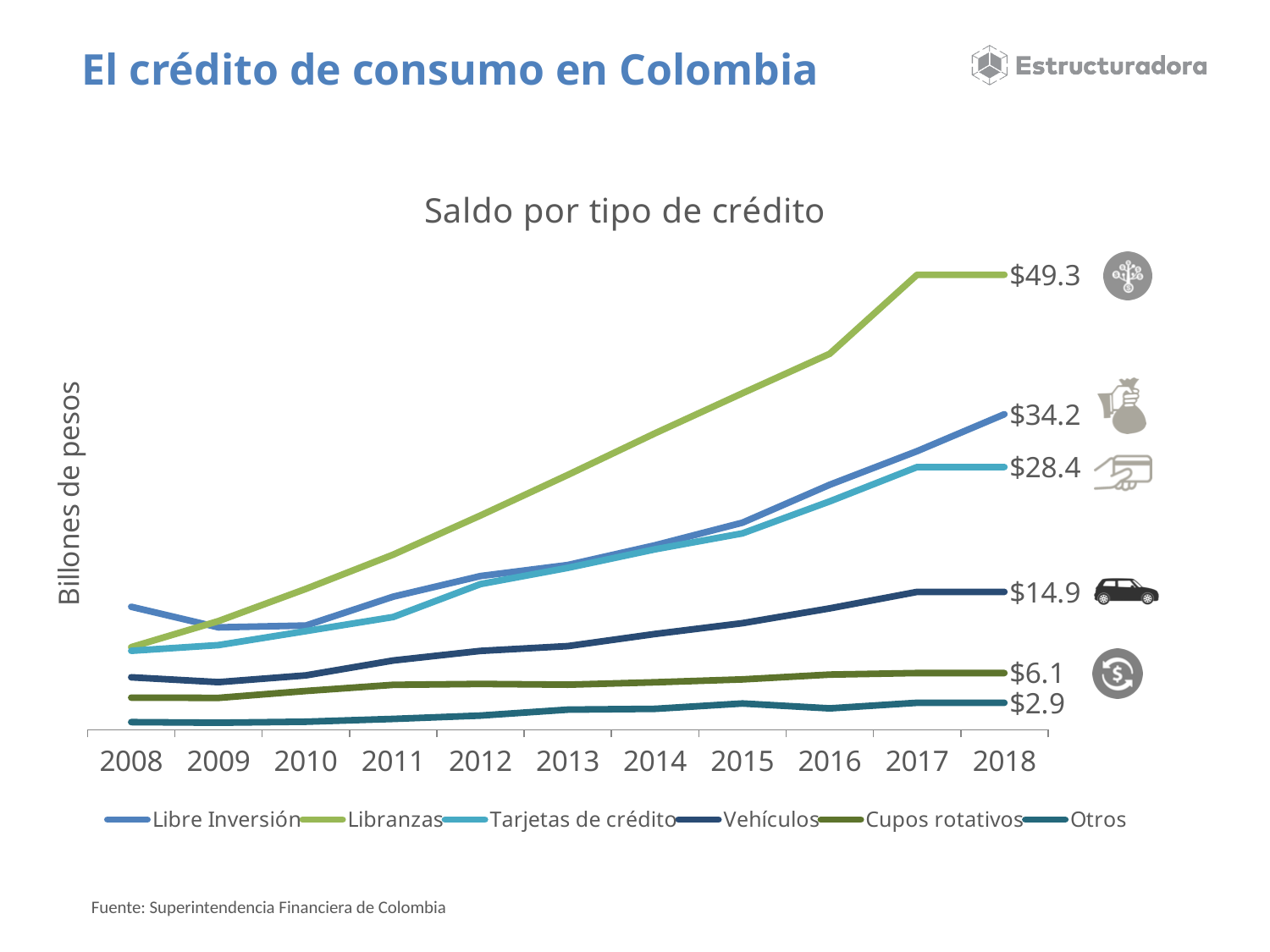
How many years are shown on the x axis? 11 Does the Libranzas line rise or fall from 2008 to 2018? rise What is the difference between Libranzas and Libre Inversión in 2018? $15.1 What is the value for Vehículos in 2018? $14.9 What type of chart is shown on the slide? line chart Which credit type has the lowest value in 2018? Otros What is the value for Libranzas in 2018? $49.3 How many series does the legend list? 6 What is the value for Tarjetas de crédito in 2018? $28.4 What is the chart's title? Saldo por tipo de crédito Which credit type has the highest value in 2018? Libranzas What is the value for Libre Inversión in 2018? $34.2